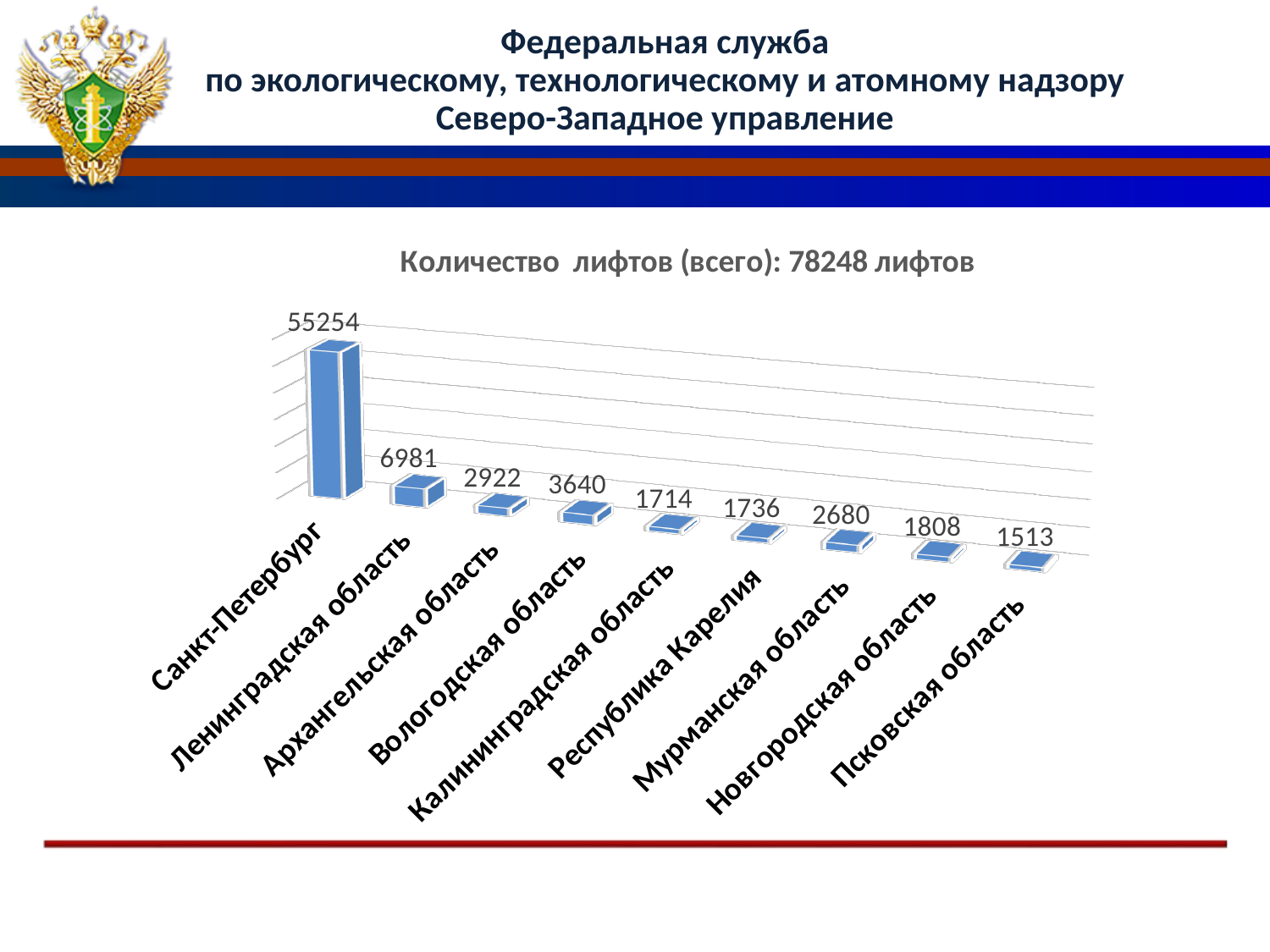
Which region has the highest number of lifts? Санкт-Петербург What total number of lifts is stated in the chart title? 78248 лифтов What is the value shown for Псковская область? 1513 What is the difference between the values for Санкт-Петербург and Ленинградская область? 48273 Which has more lifts, Мурманская область or Новгородская область? Мурманская область What is the difference between the values for Вологодская область and Архангельская область? 718 What kind of chart is shown on the slide? Bar chart What is the number of lifts for Ленинградская область? 6981 What is the number of lifts for Санкт-Петербург? 55254 What is the value shown for Вологодская область? 3640 Which region has the lowest number of lifts? Псковская область How many regions are shown on the chart? 9